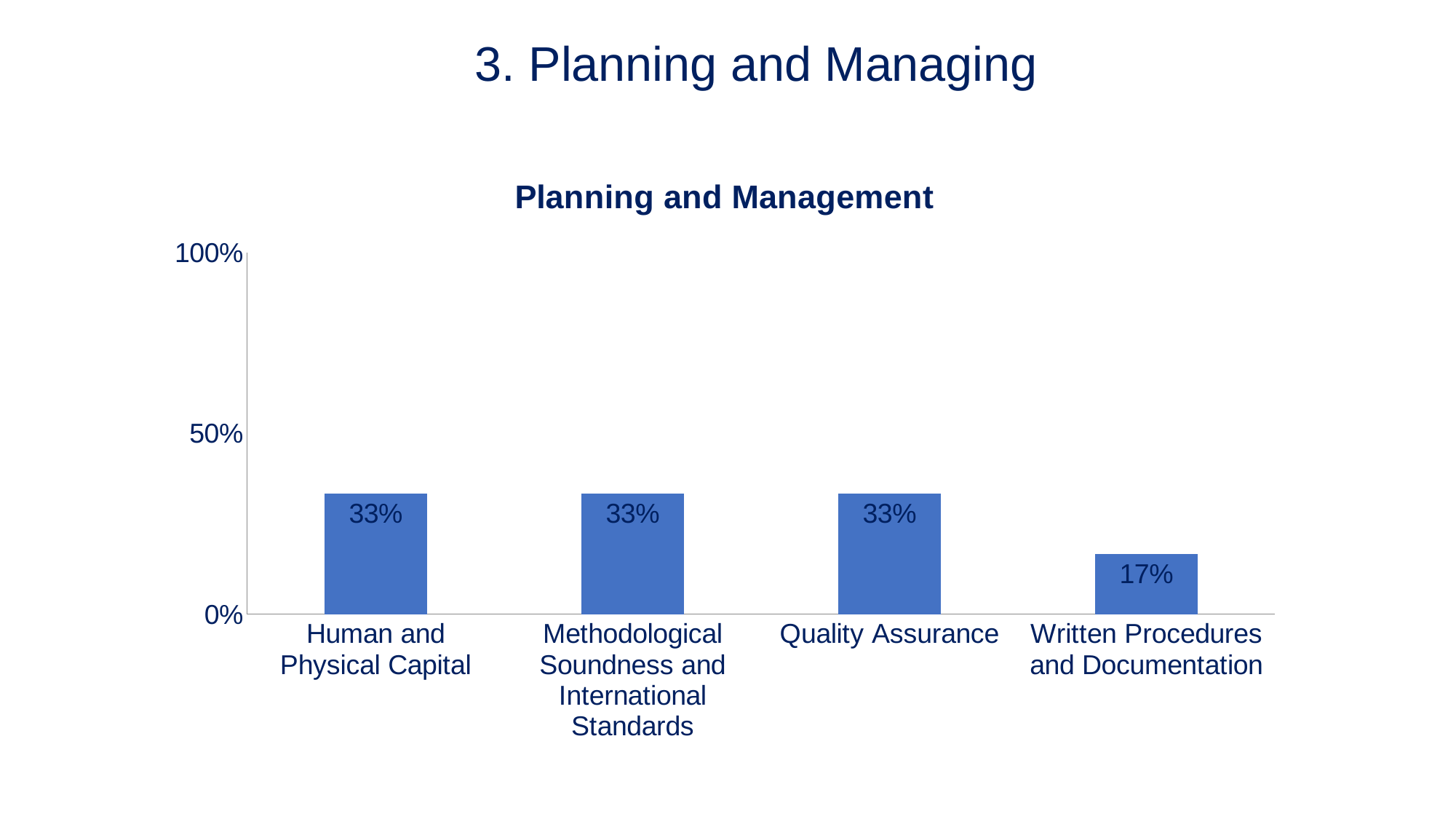
Which is larger, the value for Human and Physical Capital or the value for Written Procedures and Documentation? Human and Physical Capital What is the value for Quality Assurance? 33% What kind of chart is shown on the slide? bar chart What is the title of the chart? Planning and Management What is the value for Methodological Soundness and International Standards? 33% What is the difference between the values for Quality Assurance and Written Procedures and Documentation? 16% Is the value for Quality Assurance greater or less than 50%? less How many categories are shown on the chart? 4 What is the highest value shown on the vertical axis? 100% What is the value for Written Procedures and Documentation? 17% Which category has the lowest value? Written Procedures and Documentation What is the value for Human and Physical Capital? 33%